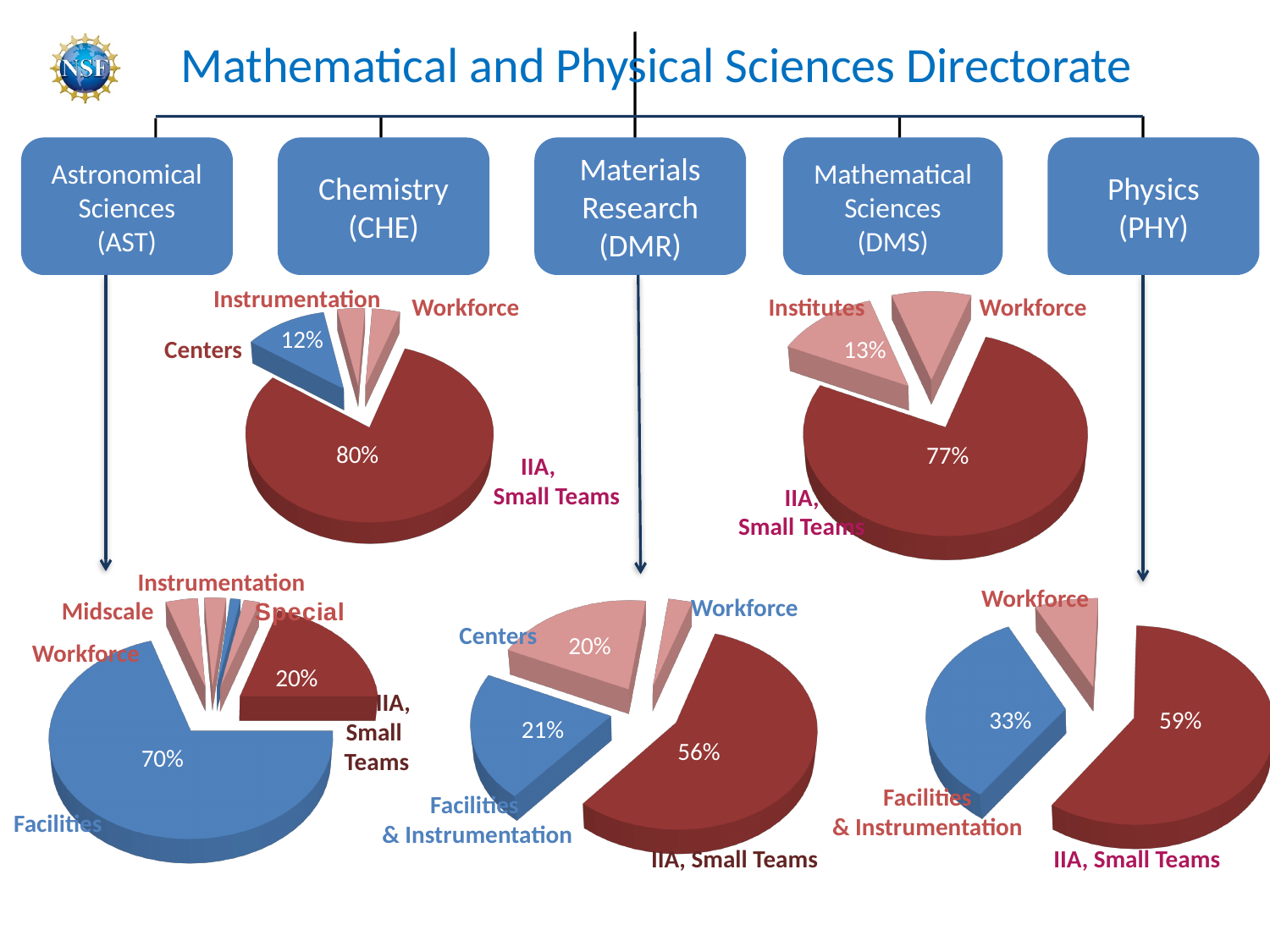
How many pie charts are shown on the slide? 5 In the Physics (PHY) pie chart, which is larger: IIA, Small Teams or Facilities & Instrumentation? IIA, Small Teams What type of chart is used for each division on the slide? Pie chart In the Materials Research (DMR) pie chart, what share goes to Facilities & Instrumentation? 21% In the Materials Research (DMR) pie chart, what is the difference between the IIA, Small Teams share and the Centers share? 36 percentage points In the Chemistry (CHE) pie chart, what share goes to IIA, Small Teams? 80% In the Astronomical Sciences (AST) pie chart, what share goes to Facilities? 70% In the Physics (PHY) pie chart, what share goes to Facilities & Instrumentation? 33% In the Chemistry (CHE) pie chart, what percentage is labelled for Centers? 12% In the Mathematical Sciences (DMS) pie chart, what percentage is labelled for Institutes? 13% In the Mathematical Sciences (DMS) pie chart, what share goes to IIA, Small Teams? 77% In the Astronomical Sciences (AST) pie chart, which category has the largest slice? Facilities